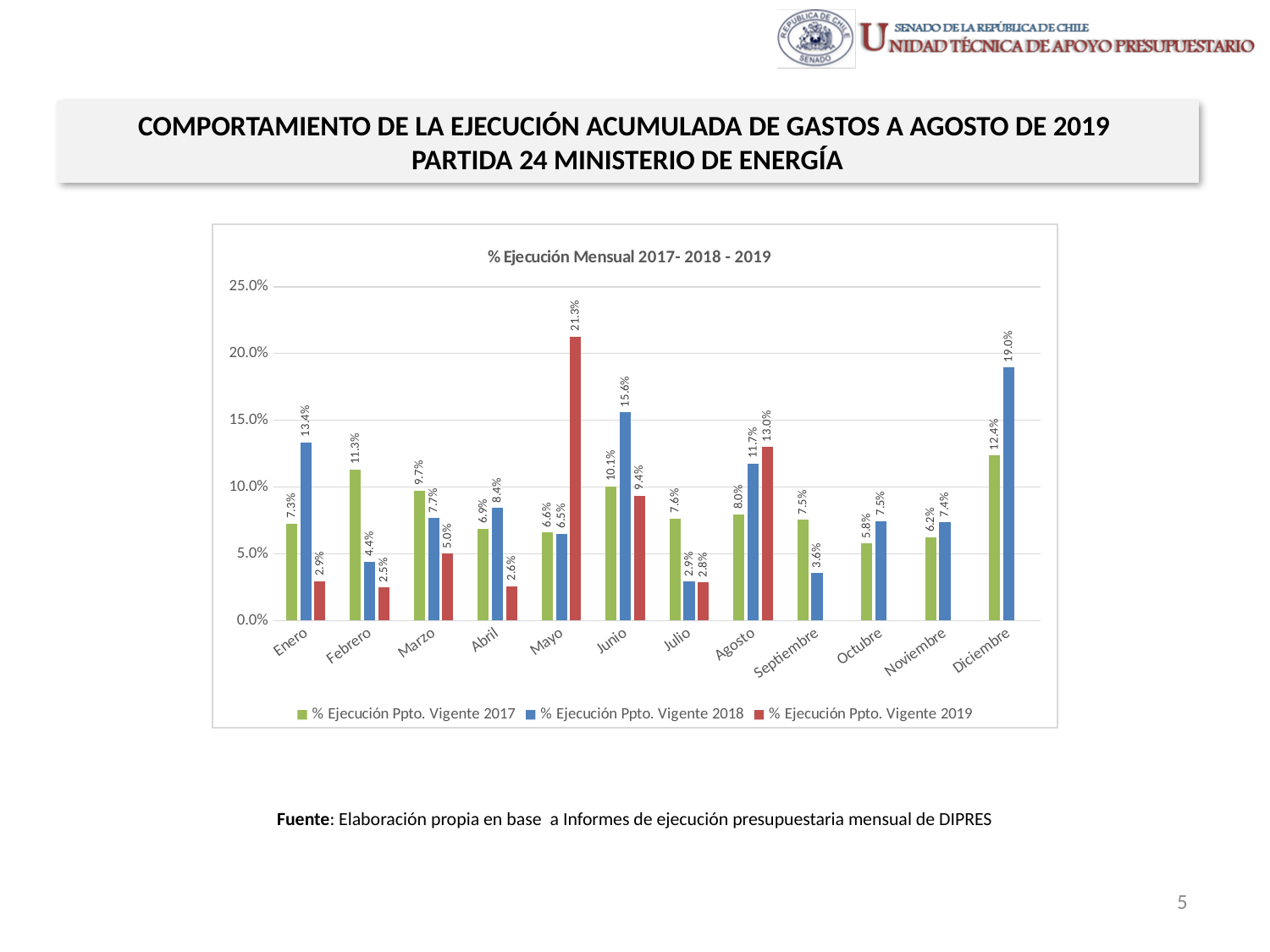
How many months are shown on the x axis? 12 What is the value for % Ejecución Ppto. Vigente 2019 in Mayo? 21.3% Which month has the lowest value for % Ejecución Ppto. Vigente 2017? Octubre In Agosto, which series has the larger value: % Ejecución Ppto. Vigente 2018 or % Ejecución Ppto. Vigente 2019? % Ejecución Ppto. Vigente 2019 What kind of chart is shown on the slide? Bar chart What is the value for % Ejecución Ppto. Vigente 2017 in Febrero? 11.3% What is the difference between the 2018 and 2017 values in Enero? 6.1% What is the value for % Ejecución Ppto. Vigente 2018 in Diciembre? 19.0% Is the value for % Ejecución Ppto. Vigente 2018 in Junio greater or less than 15.0%? greater How many series does the legend list? 3 What is the title of the chart? % Ejecución Mensual 2017- 2018 - 2019 Which month has the highest value for % Ejecución Ppto. Vigente 2019? Mayo